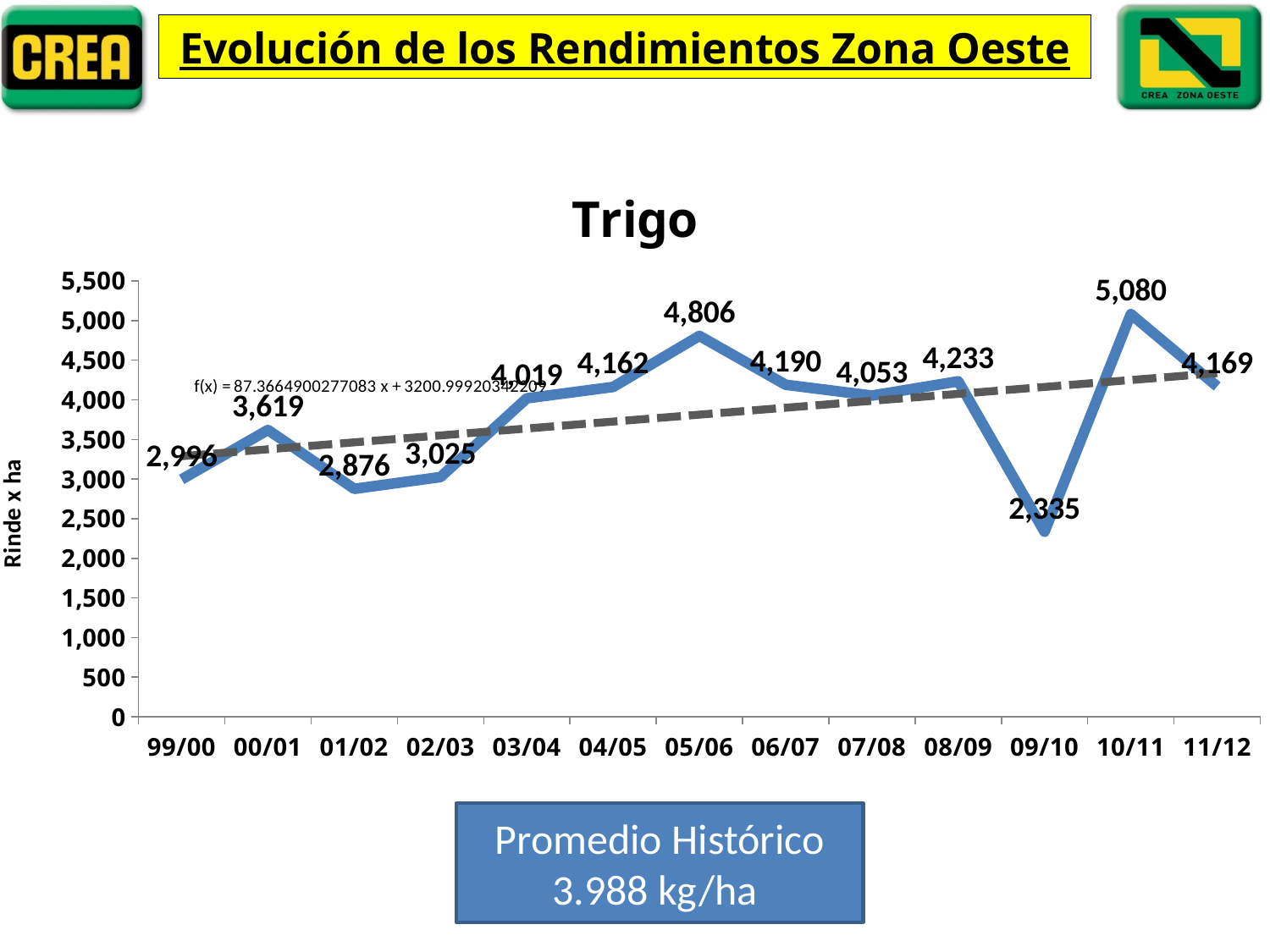
What kind of chart is the Trigo chart? line chart What is the difference between the values for 10/11 and 09/10 in the Trigo chart? 2,745 What is the y-axis label of the Trigo chart? Rinde x ha What is the value for 09/10 in the Trigo chart? 2,335 What is the difference between the values for 00/01 and 01/02 in the Trigo chart? 743 Does the dashed trend line in the Trigo chart rise or fall from left to right? rise How many seasons are plotted in the Trigo chart? 13 Which season has the lowest value in the Trigo chart? 09/10 What is the value for 99/00 in the Trigo chart? 2,996 What is the value for 05/06 in the Trigo chart? 4,806 Which is larger in the Trigo chart, the value for 06/07 or the value for 07/08? 06/07 Which season has the highest value in the Trigo chart? 10/11